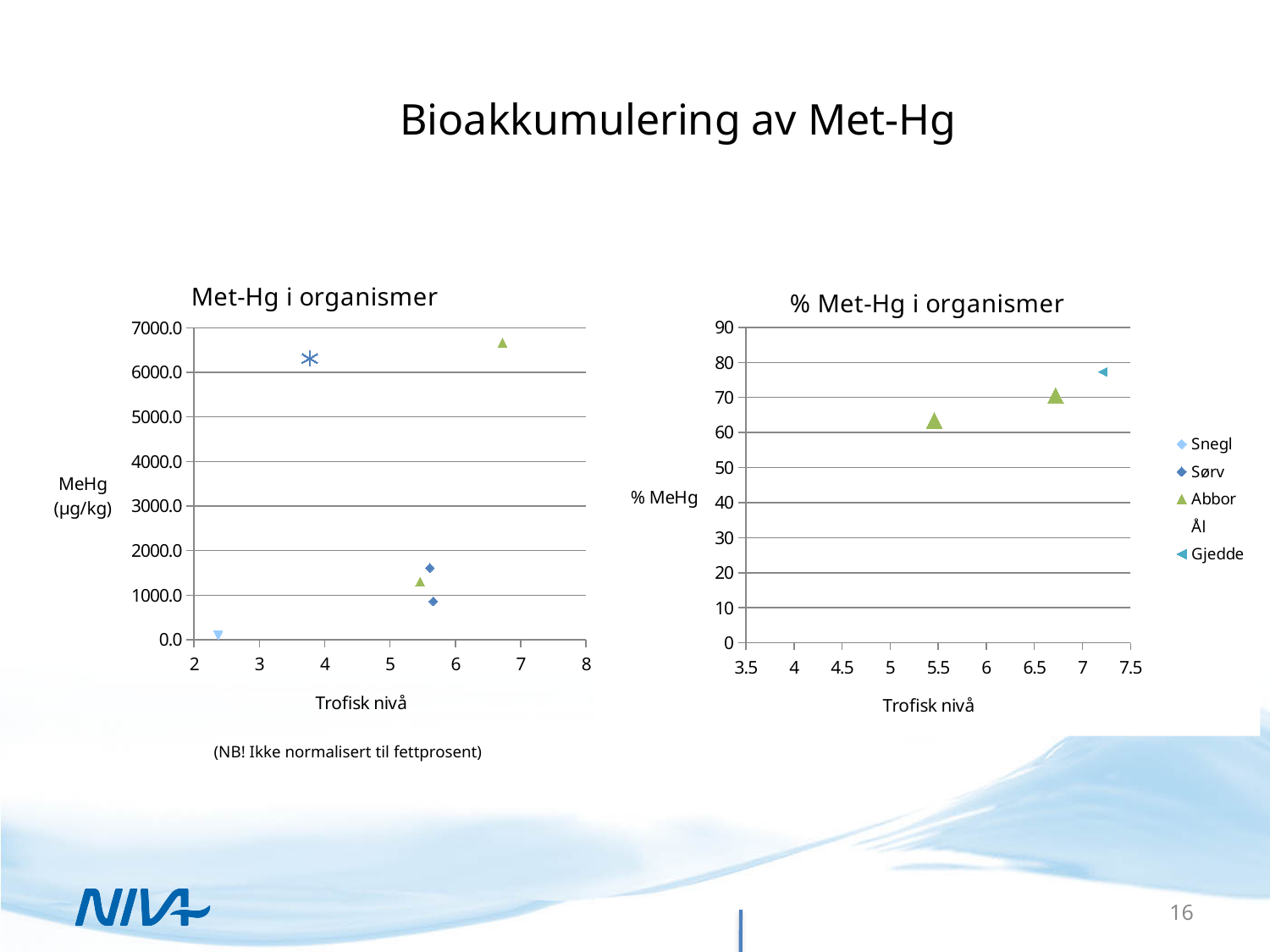
In the right chart "% Met-Hg i organismer", which series has the highest % MeHg value? Gjedde In the left chart "Met-Hg i organismer", which series has the lowest MeHg value? Snegl What kind of chart is the left chart titled "Met-Hg i organismer"? scatter chart In the right chart "% Met-Hg i organismer", is the value for Gjedde greater or less than 70? greater What is the x-axis label of the right chart "% Met-Hg i organismer"? Trofisk nivå In the left chart "Met-Hg i organismer", is the value for Snegl greater or less than 1000.0? less How many series does the legend on the slide list? 5 What is the y-axis label of the left chart? MeHg (µg/kg) In the right chart "% Met-Hg i organismer", is the Abbor point at the lower trophic level greater or less than 60? greater In the right chart "% Met-Hg i organismer", do the % MeHg values rise or fall as Trofisk nivå increases? rise In the right chart "% Met-Hg i organismer", how many data points are plotted? 3